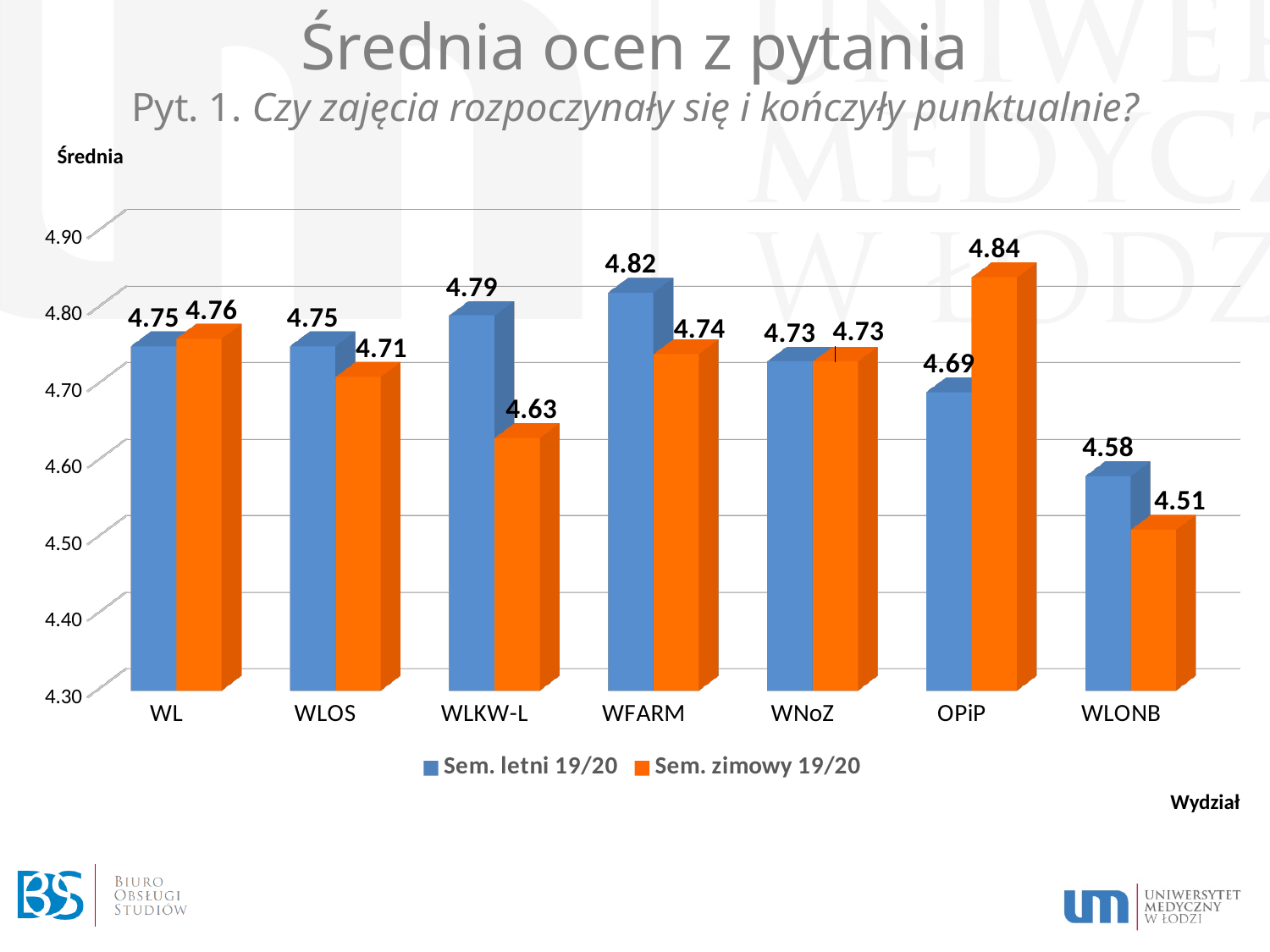
What kind of chart is shown on the slide? bar chart Which category has the highest value in the Sem. letni 19/20 series? WFARM What is the label of the y axis? Średnia What is the value for WLKW-L in the Sem. zimowy 19/20 series? 4.63 What is the value for WFARM in the Sem. letni 19/20 series? 4.82 How many series does the legend list? 2 Which category has the lowest value in the Sem. zimowy 19/20 series? WLONB What is the value for OPiP in the Sem. zimowy 19/20 series? 4.84 Which is larger for OPiP: the Sem. letni 19/20 value or the Sem. zimowy 19/20 value? Sem. zimowy 19/20 How many categories (faculties) are shown on the x axis? 7 Is the Sem. letni 19/20 value for WLONB greater or less than 4.60? less What is the difference between the Sem. letni 19/20 and Sem. zimowy 19/20 values for WLKW-L? 0.16